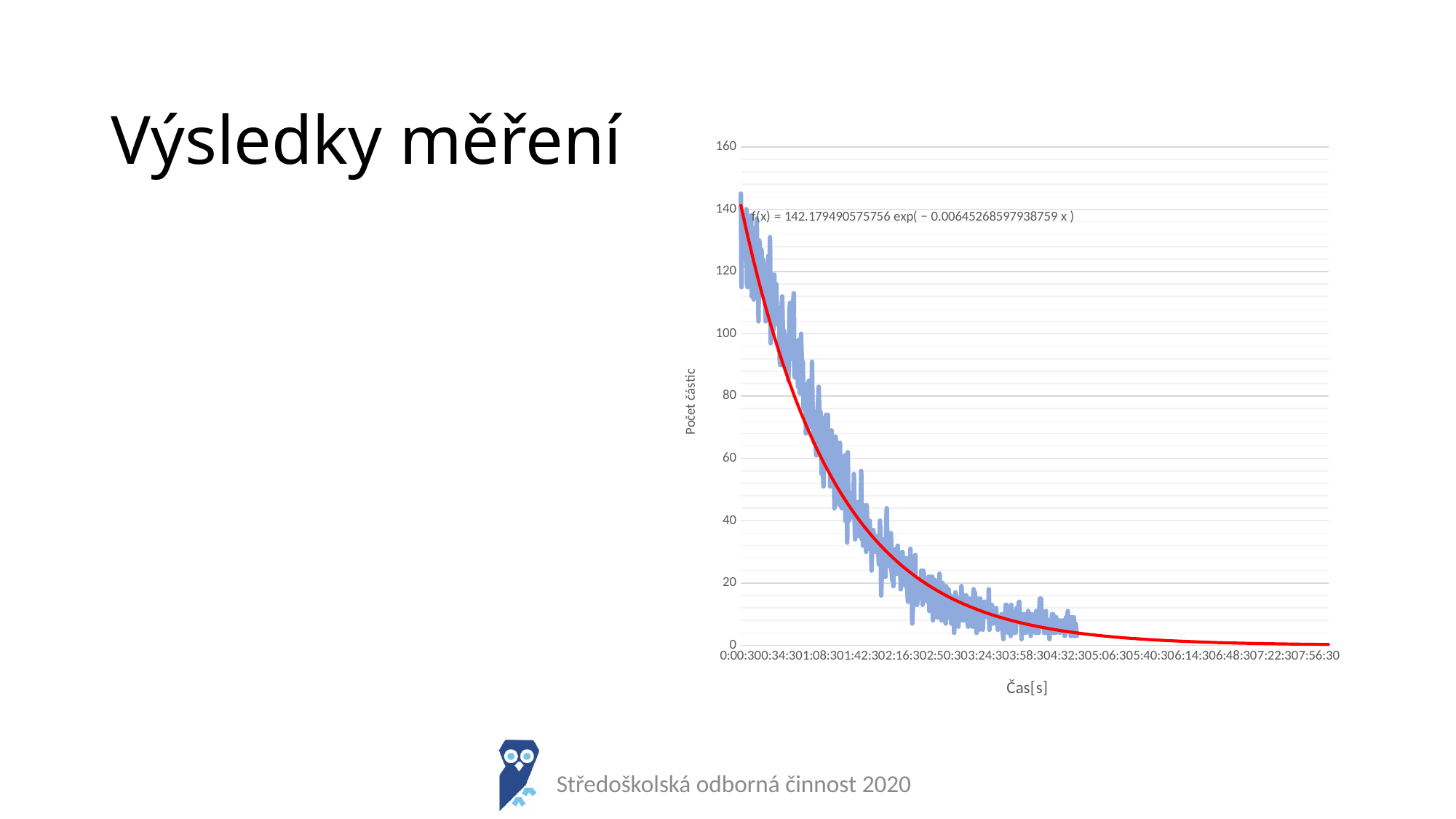
Do the plotted values rise or fall as time increases along the x axis? fall What is the label of the vertical axis? Počet částic What is the highest tick value shown on the vertical axis? 160 Is the value at 4:32:30 greater or less than 20? less Is the value at 3:24:30 greater or less than 40? less What is the label of the horizontal axis? Čas[s] What kind of chart is shown on the slide? line chart Is the value at the start of the measurement (0:00:30) greater or less than 100? greater